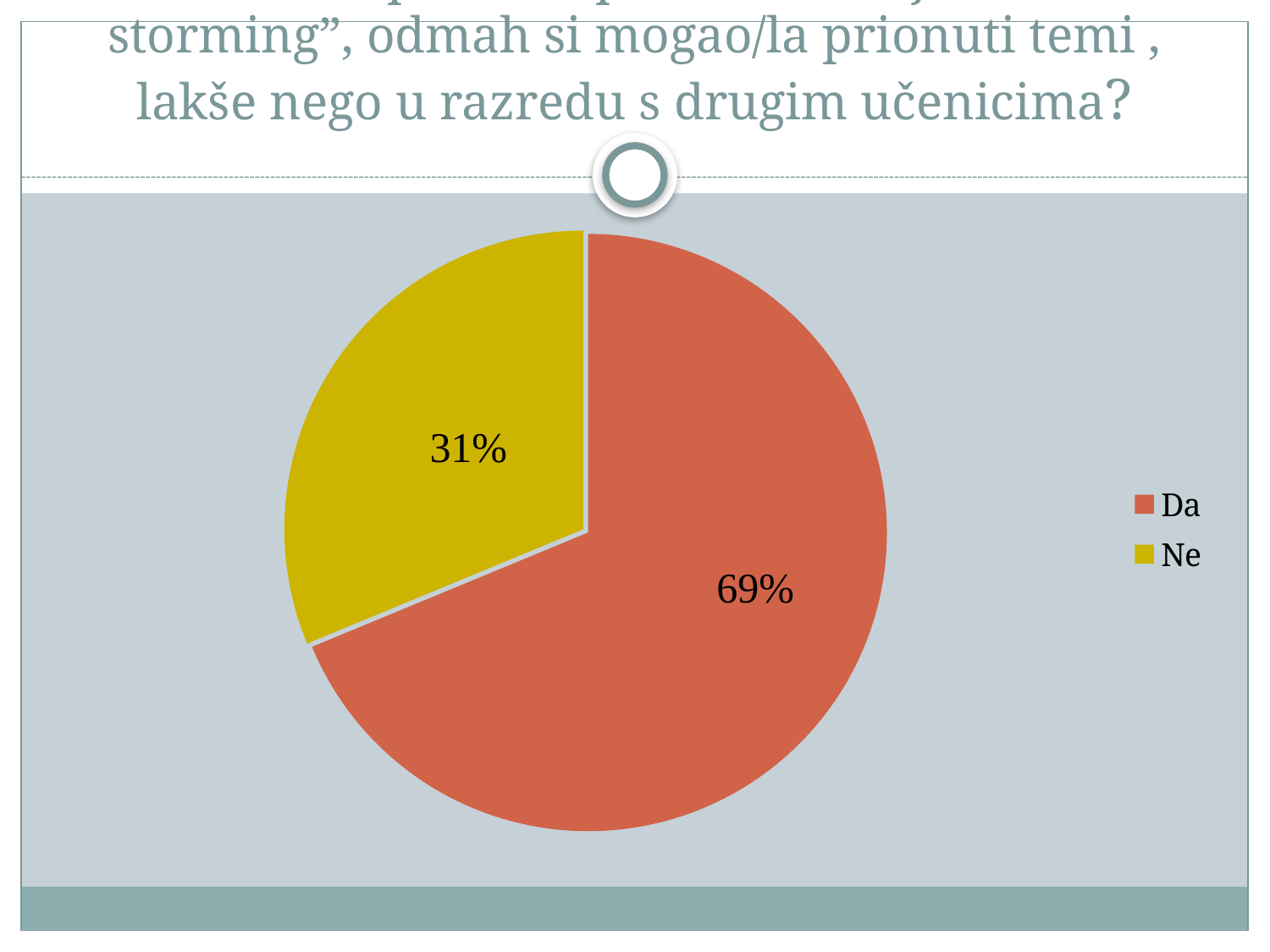
What percentage of the pie is labelled "Ne"? 31% What colour is the "Da" slice? red/orange How many entries does the legend list? 2 What kind of chart is shown on the slide? pie chart Which category has the smallest share of the pie? Ne What percentage of the pie is labelled "Da"? 69% What is the difference in percentage points between the "Da" and "Ne" slices? 38 What colour is the "Ne" slice? yellow How many slices does the pie chart have? 2 Which category has the largest share of the pie? Da Which slice is larger, "Da" or "Ne"? Da What share of the pie does the "Ne" slice represent? 31%